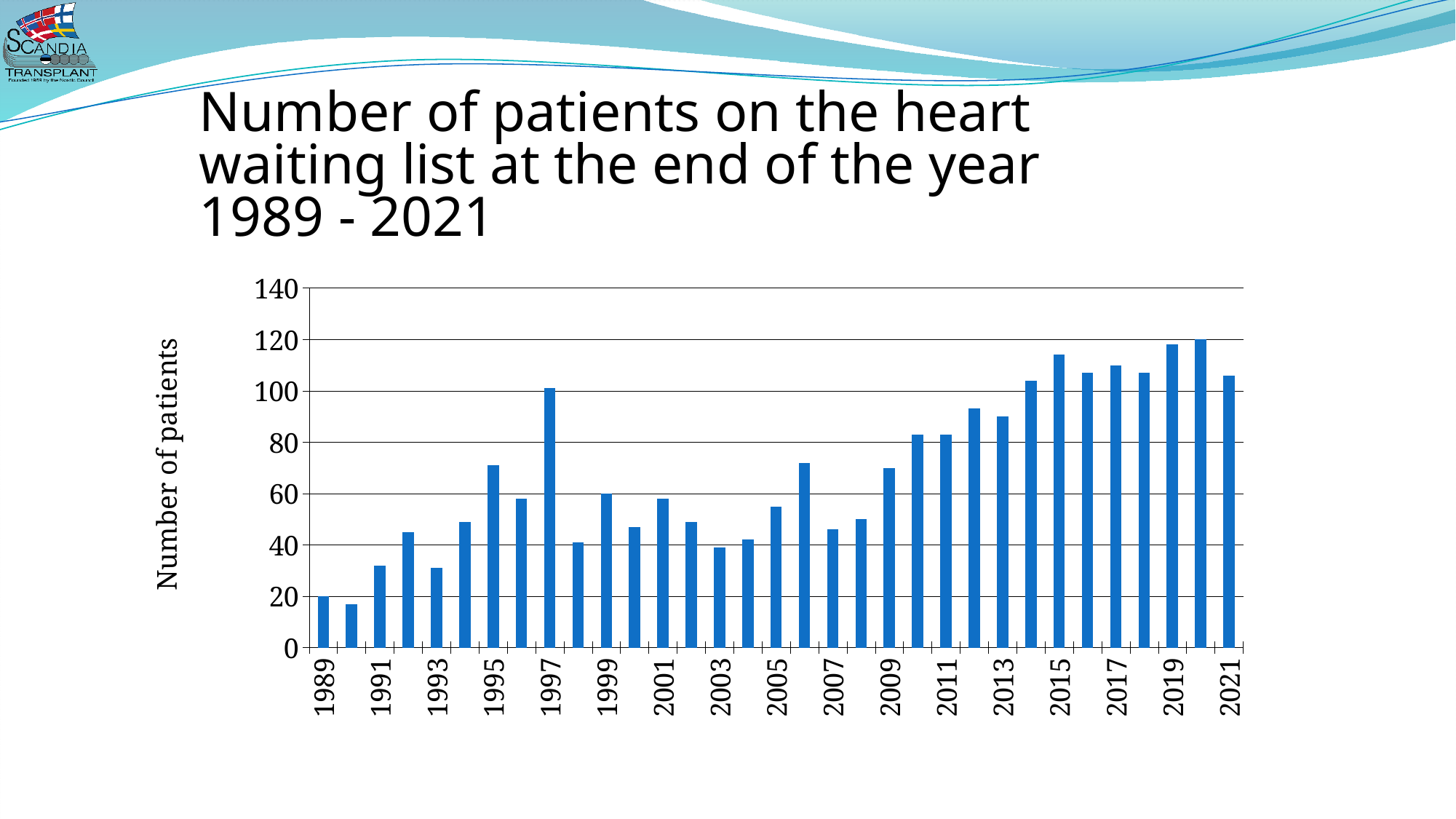
Is the value for 2012 greater or less than 80? greater What is the label on the vertical axis of the chart? Number of patients Do the values generally rise or fall from 2009 to 2015? rise Is the value for 2003 greater or less than 60? less Is the value for 2021 greater or less than 100? greater How many years (bars) are plotted on the chart? 33 Which year has the larger value, 1996 or 1997? 1997 Which year has the larger value, 2009 or 2015? 2015 What is the title of the chart on the slide? Number of patients on the heart waiting list at the end of the year 1989 - 2021 What kind of chart is shown on the slide? bar chart